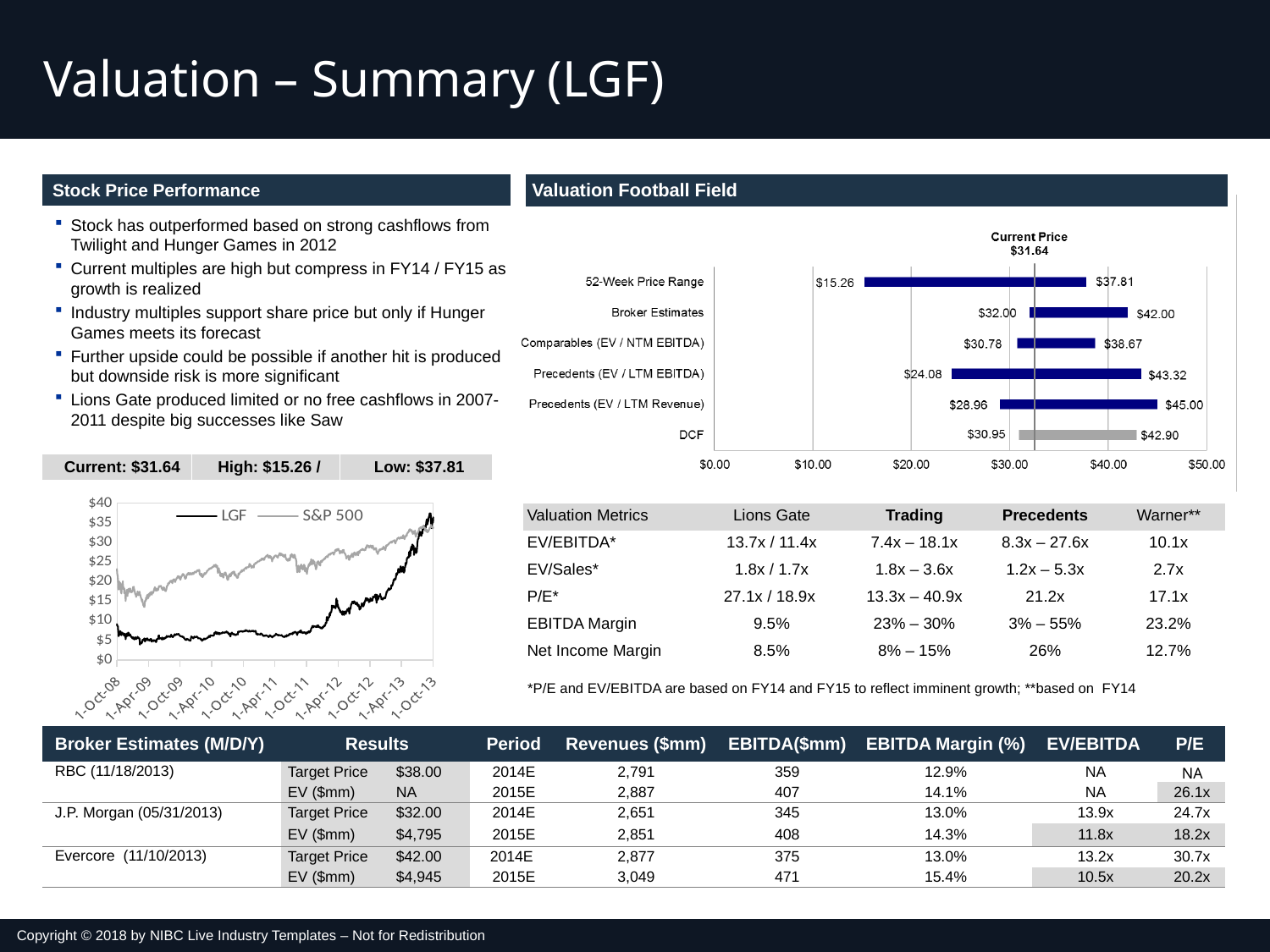
In the Valuation Football Field chart, what is the high end of the DCF range? $42.90 In the Valuation Football Field chart, what current price is marked? $31.64 In the Valuation Football Field chart, what is the low end of the 52-Week Price Range? $15.26 In the Valuation Football Field chart, which valuation method has the lowest low value? 52-Week Price Range In the Valuation Football Field chart, which valuation method has the highest upper value? Precedents (EV / LTM Revenue) What kind of chart is the Valuation Football Field? Bar chart In the Stock Price Performance chart, does the LGF line rise or fall overall from 1-Oct-08 to 1-Oct-13? Rise How many series does the legend of the Stock Price Performance line chart list? 2 In the Valuation Football Field chart, what is the difference between the high and low ends of the Precedents (EV / LTM EBITDA) range? $19.24 In the Valuation Football Field chart, what is the high end of the Broker Estimates range? $42.00 In the Valuation Football Field chart, which is larger: the low end of Comparables (EV / NTM EBITDA) or the low end of Precedents (EV / LTM Revenue)? Comparables (EV / NTM EBITDA) How many valuation methods are shown in the Valuation Football Field chart? 6